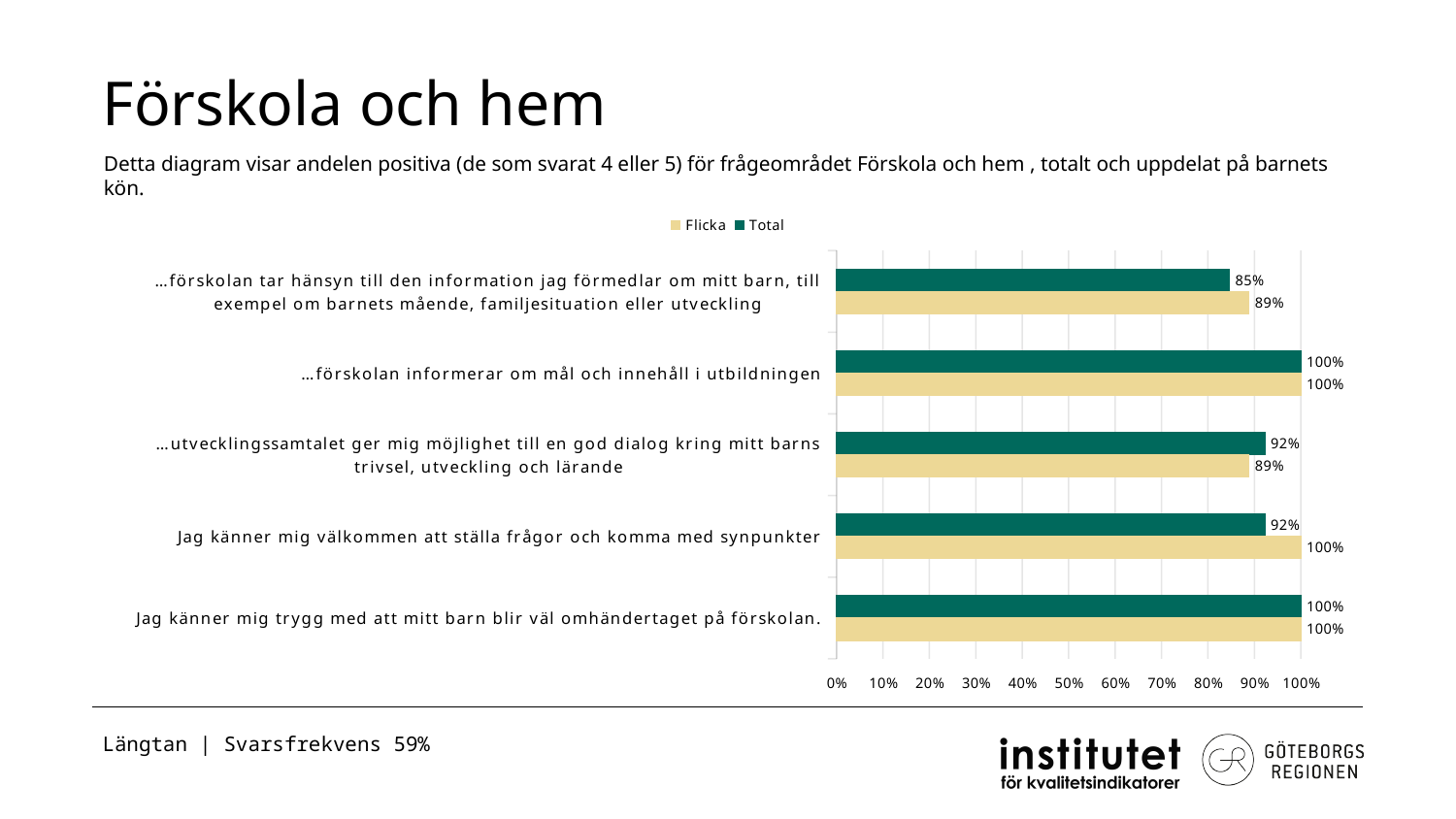
What is the difference between the Flicka and Total values for "Jag känner mig välkommen att ställa frågor och komma med synpunkter"? 8% What is the Flicka value for "…utvecklingssamtalet ger mig möjlighet till en god dialog kring mitt barns trivsel, utveckling och lärande"? 89% How many categories (statements) are shown in the chart? 5 What is the Flicka value for "…förskolan tar hänsyn till den information jag förmedlar om mitt barn, till exempel om barnets mående, familjesituation eller utveckling"? 89% For "…förskolan tar hänsyn till den information jag förmedlar om mitt barn, till exempel om barnets mående, familjesituation eller utveckling", which is larger, the Flicka value or the Total value? Flicka What is the Total value for "Jag känner mig välkommen att ställa frågor och komma med synpunkter"? 92% What is the Total value for "Jag känner mig trygg med att mitt barn blir väl omhändertaget på förskolan."? 100% What is the difference between the Total and Flicka values for "…utvecklingssamtalet ger mig möjlighet till en god dialog kring mitt barns trivsel, utveckling och lärande"? 3% Which category has the lowest Total value? …förskolan tar hänsyn till den information jag förmedlar om mitt barn, till exempel om barnets mående, familjesituation eller utveckling Is the Total value for "…förskolan tar hänsyn till den information jag förmedlar om mitt barn, till exempel om barnets mående, familjesituation eller utveckling" greater or less than 90%? less What kind of chart is shown on the slide? Bar chart How many series does the legend list? 2